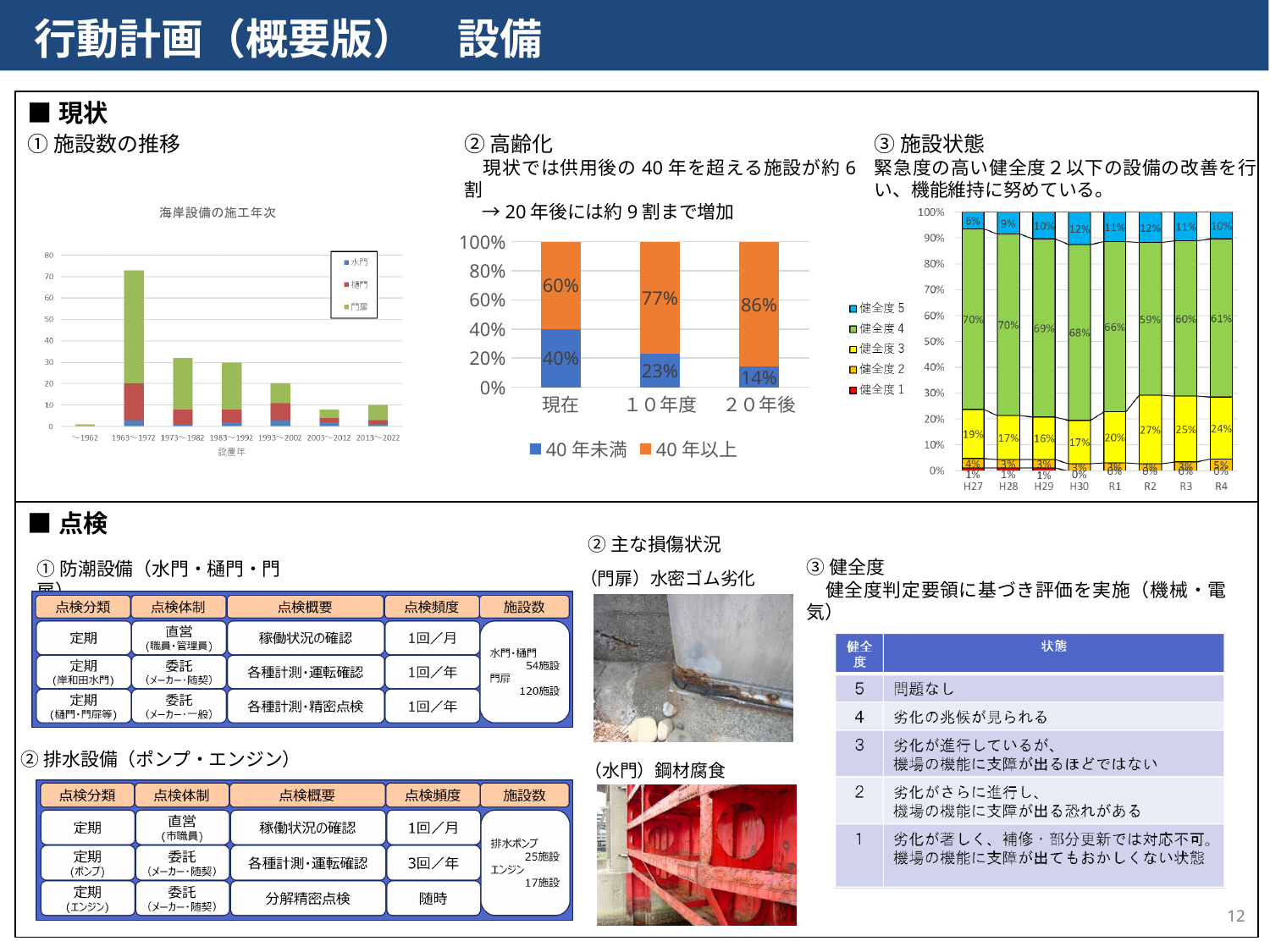
In the 高齢化 chart (middle), does the 40 年以上 share rise or fall from 現在 to ２０年後? rise In the 高齢化 chart (middle), what is the difference between the 40 年以上 values at ２０年後 and 現在? 26% In the 施設状態 chart (right), how many series does the legend list? 5 In the 海岸設備の施工年次 chart (left), which 設置年 category has the highest total? 1963～1972 In the 施設状態 chart (right), what is the value for 健全度 3 at R2? 27% In the 高齢化 chart (middle), what is the value for 40 年未満 at ２０年後? 14% In the 高齢化 chart (middle), what is the value for 40 年以上 at 現在? 60% In the 海岸設備の施工年次 chart (left), is the total for 1963～1972 greater or less than 60? greater In the 施設状態 chart (right), how many years are shown on the x axis? 8 In the 高齢化 chart (middle), how many series does the legend list? 2 In the 施設状態 chart (right), which year has the highest 健全度 3 value? R2 In the 施設状態 chart (right), what is the value for 健全度 4 at H27? 70%